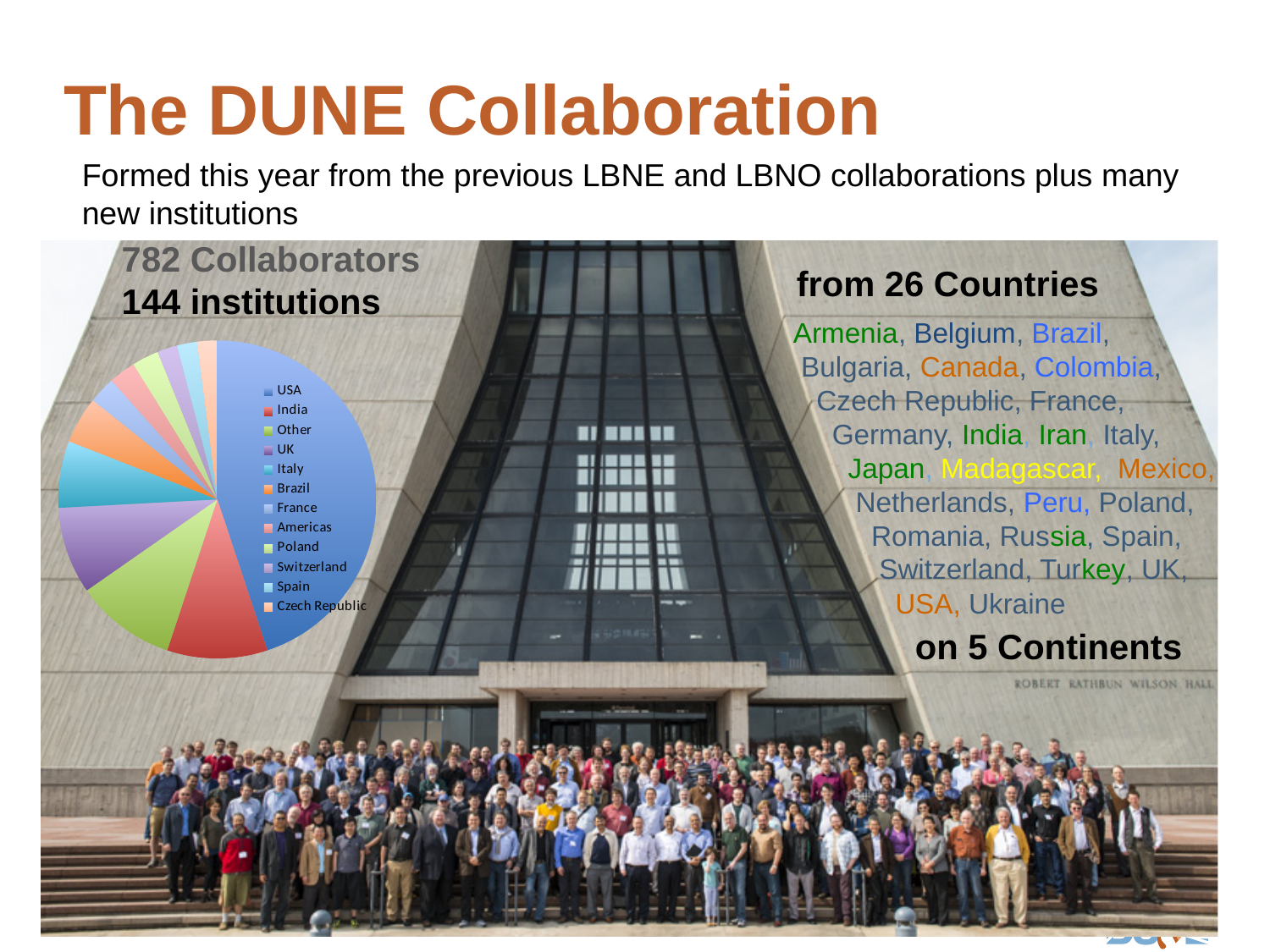
Which category is listed last in the pie chart's legend? Czech Republic Which category has the largest slice in the pie chart? USA Which slice is larger in the pie chart, USA or India? USA Which slice is larger in the pie chart, USA or Other? USA Which category is listed first in the pie chart's legend? USA How many categories does the pie chart's legend list? 12 What kind of chart is shown on the slide? pie chart Which slice is larger in the pie chart, India or Czech Republic? India